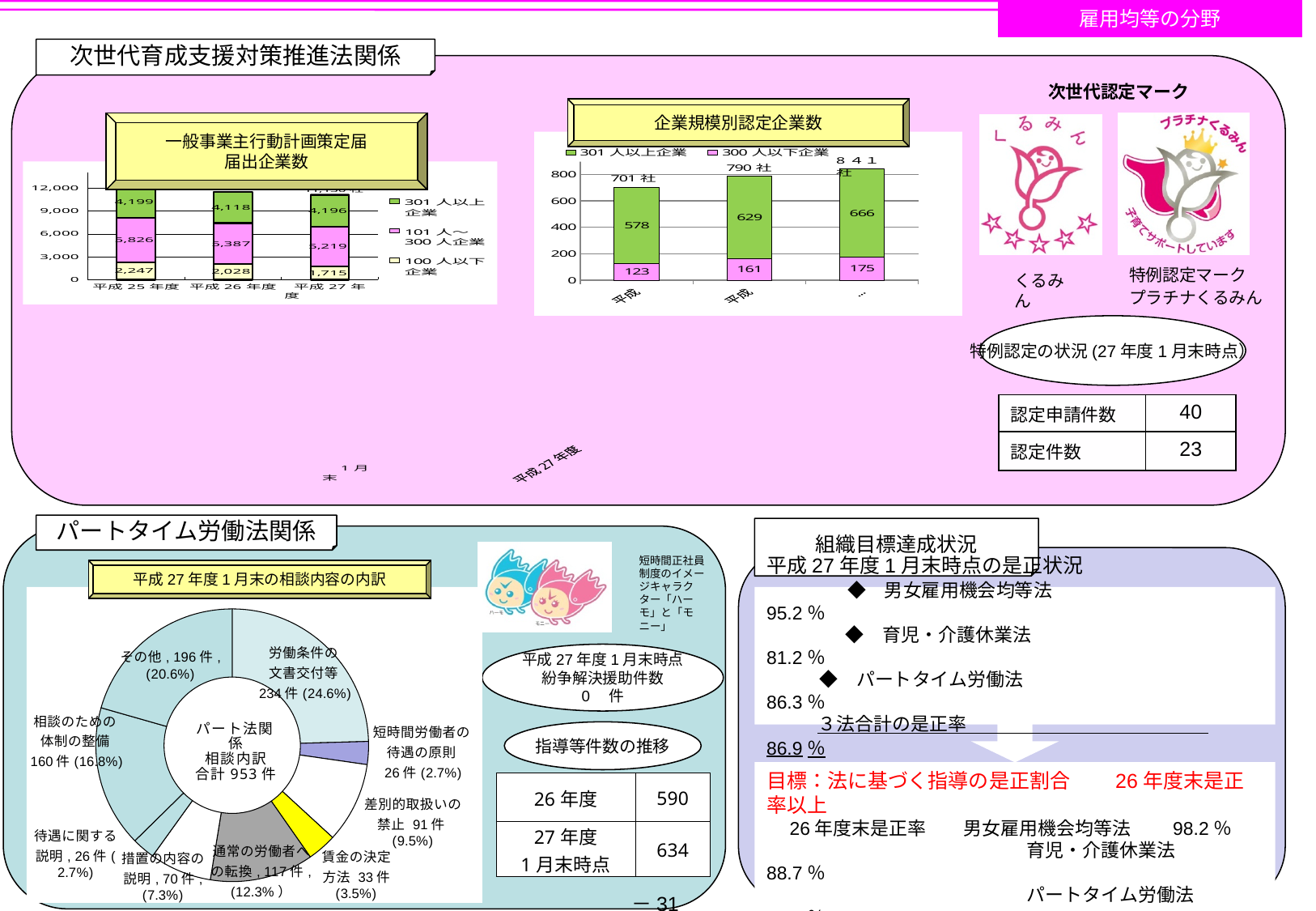
In the 一般事業主行動計画策定届 届出企業数 chart, does the value for 101人～300人企業 rise or fall from 平成25年度 to 平成27年度? fall In the 一般事業主行動計画策定届 届出企業数 chart, which year has the lowest value for 100人以下企業? 平成27年度 In the 企業規模別認定企業数 chart, what is the difference between the 301人以上企業 values of the third bar and the first bar? 88 In the 一般事業主行動計画策定届 届出企業数 chart, what is the value for 101人～300人企業 in 平成25年度? 5,826 In the 平成27年度1月末の相談内容の内訳 pie chart, how many slices are there? 9 In the 企業規模別認定企業数 chart, what is the value of the 300人以下企業 segment in the third (rightmost) bar? 175 In the 企業規模別認定企業数 chart, what total is printed above the middle bar? 790社 In the 平成27年度1月末の相談内容の内訳 pie chart, how many 件 are shown for 通常の労働者への転換? 117件 In the 企業規模別認定企業数 chart, what is the value of the 301人以上企業 segment in the first (leftmost) bar? 578 In the 一般事業主行動計画策定届 届出企業数 chart, what is the value for 100人以下企業 in 平成27年度? 1,715 In the 企業規模別認定企業数 chart, how many series does the legend list? 2 In the 平成27年度1月末の相談内容の内訳 pie chart, what share does 労働条件の文書交付等 have? 24.6%